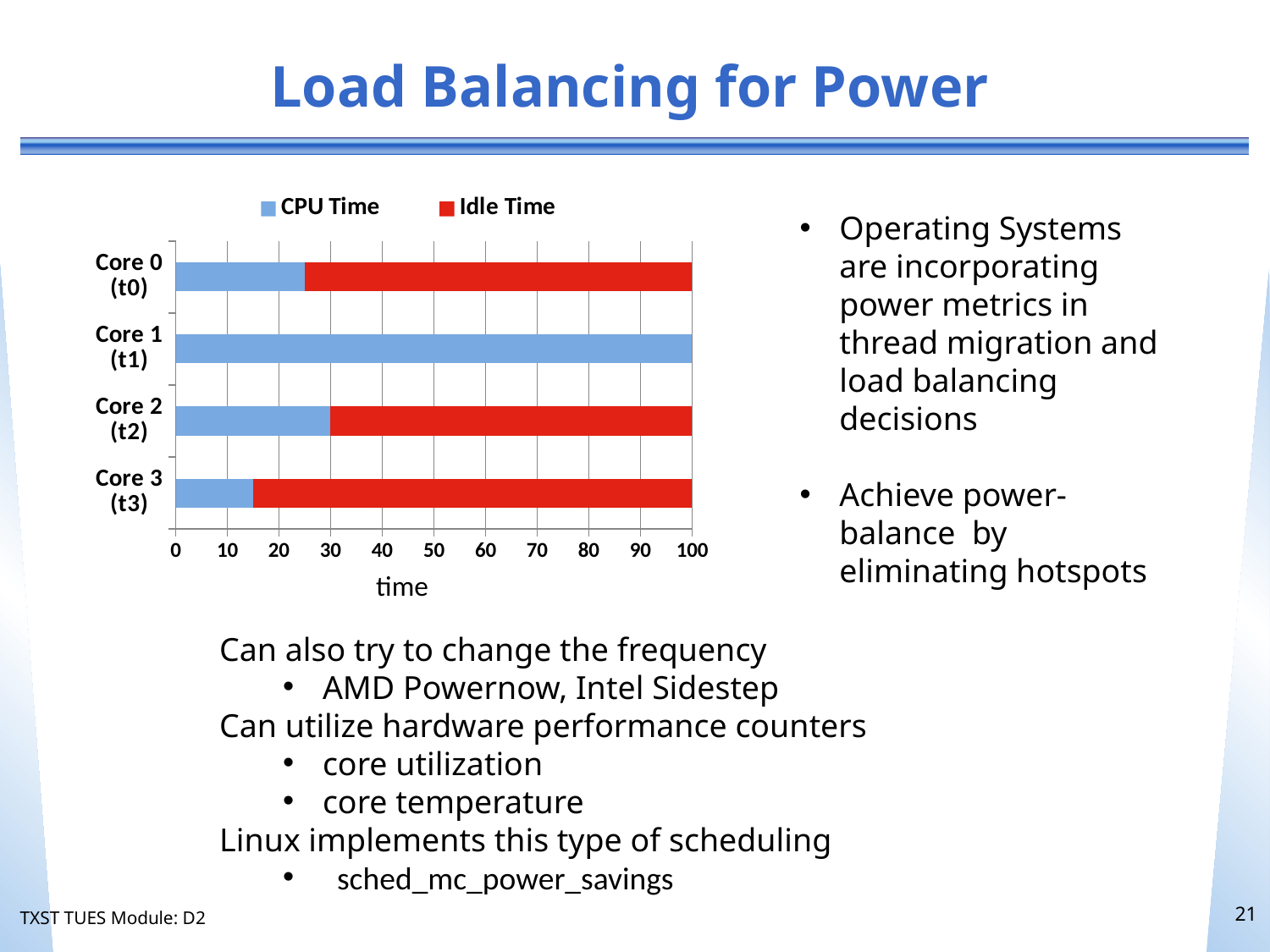
Which has more CPU Time, Core 0 (t0) or Core 3 (t3)? Core 0 (t0) Is the CPU Time for Core 3 (t3) greater or less than 20? less What is the CPU Time value for Core 1 (t1)? 100 Is the Idle Time for Core 0 (t0) greater or less than 70? greater How many cores (categories) are plotted in the chart? 4 What kind of chart is shown on the slide? Stacked bar chart Is the CPU Time for Core 0 (t0) greater or less than 30? less How many series does the chart legend list? 2 What is the label on the x axis of the chart? time Which core has the highest CPU Time? Core 1 (t1) Which core has the lowest CPU Time? Core 3 (t3) What colour represents Idle Time in the chart? Red